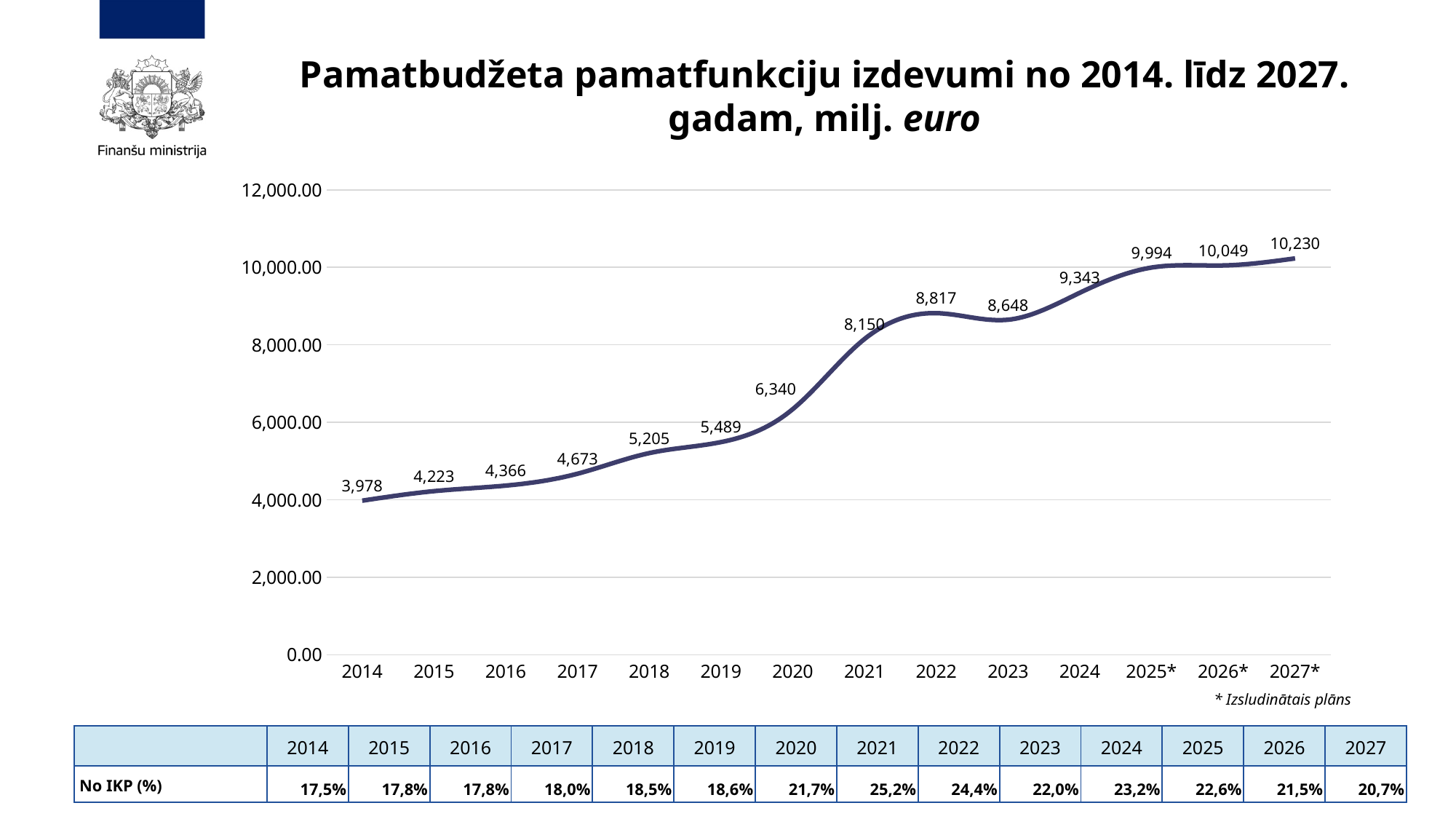
What is the value for 2021? 8,150 What is the difference between the values for 2022 and 2023? 169 What type of chart is shown on the slide? Line chart Is the value for 2020 greater or less than 6,000.00? greater What is the value for 2027*? 10,230 How many years are plotted on the x axis? 14 What is the title of the chart? Pamatbudžeta pamatfunkciju izdevumi no 2014. līdz 2027. gadam, milj. euro Which year has the lowest value? 2014 Which is larger, the value for 2022 or the value for 2023? 2022 Do the values generally rise or fall from 2014 to 2027? Rise What is the value for 2014? 3,978 Which year has the highest value? 2027*